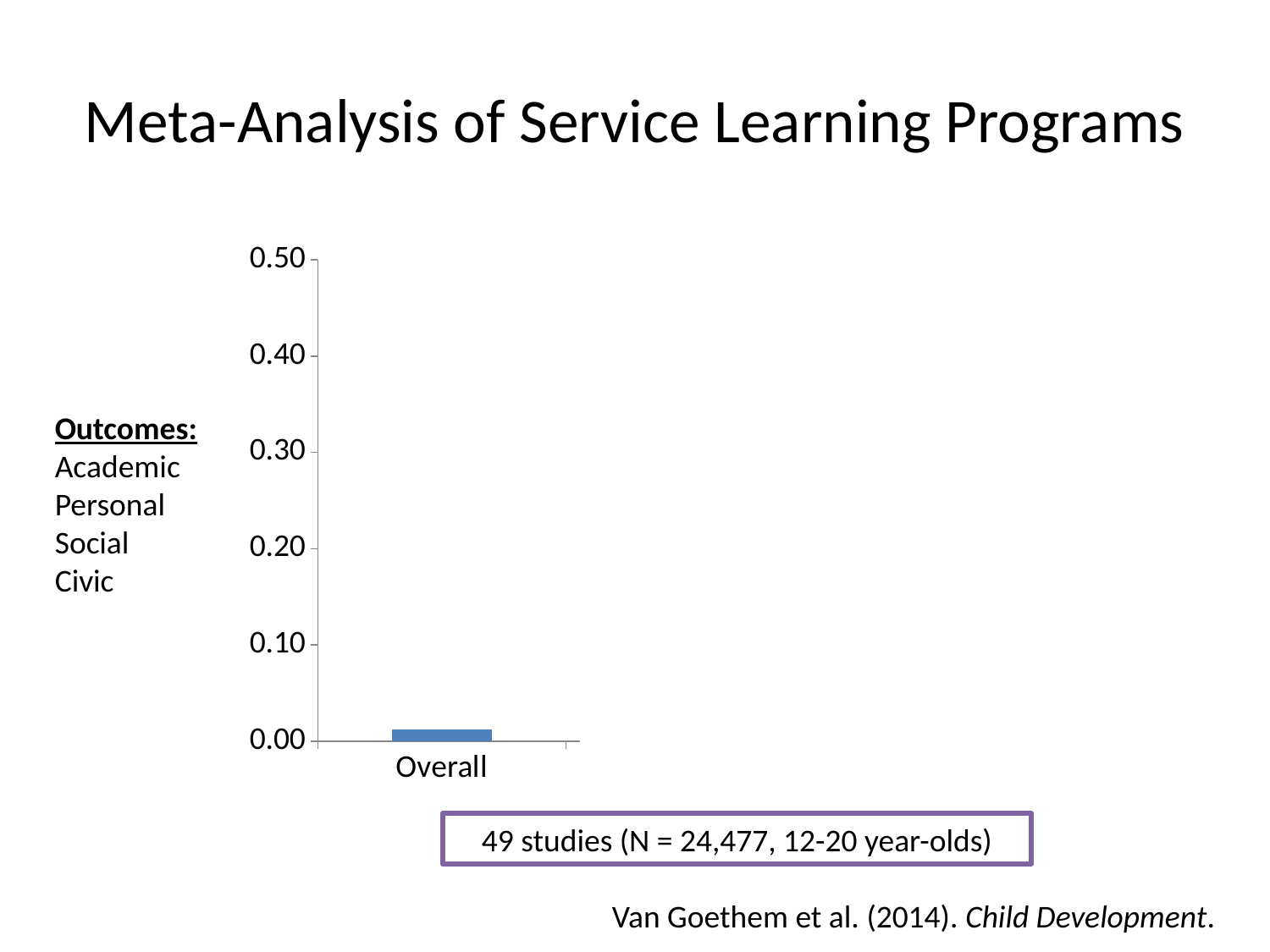
What is the label of the only category on the x axis of the chart? Overall Is the value for Overall greater or less than 0.10? less What kind of chart is shown on the slide? bar chart How many categories are plotted on the chart? 1 Is the value for Overall greater or less than 0.20? less What is the highest value shown on the chart's y axis? 0.50